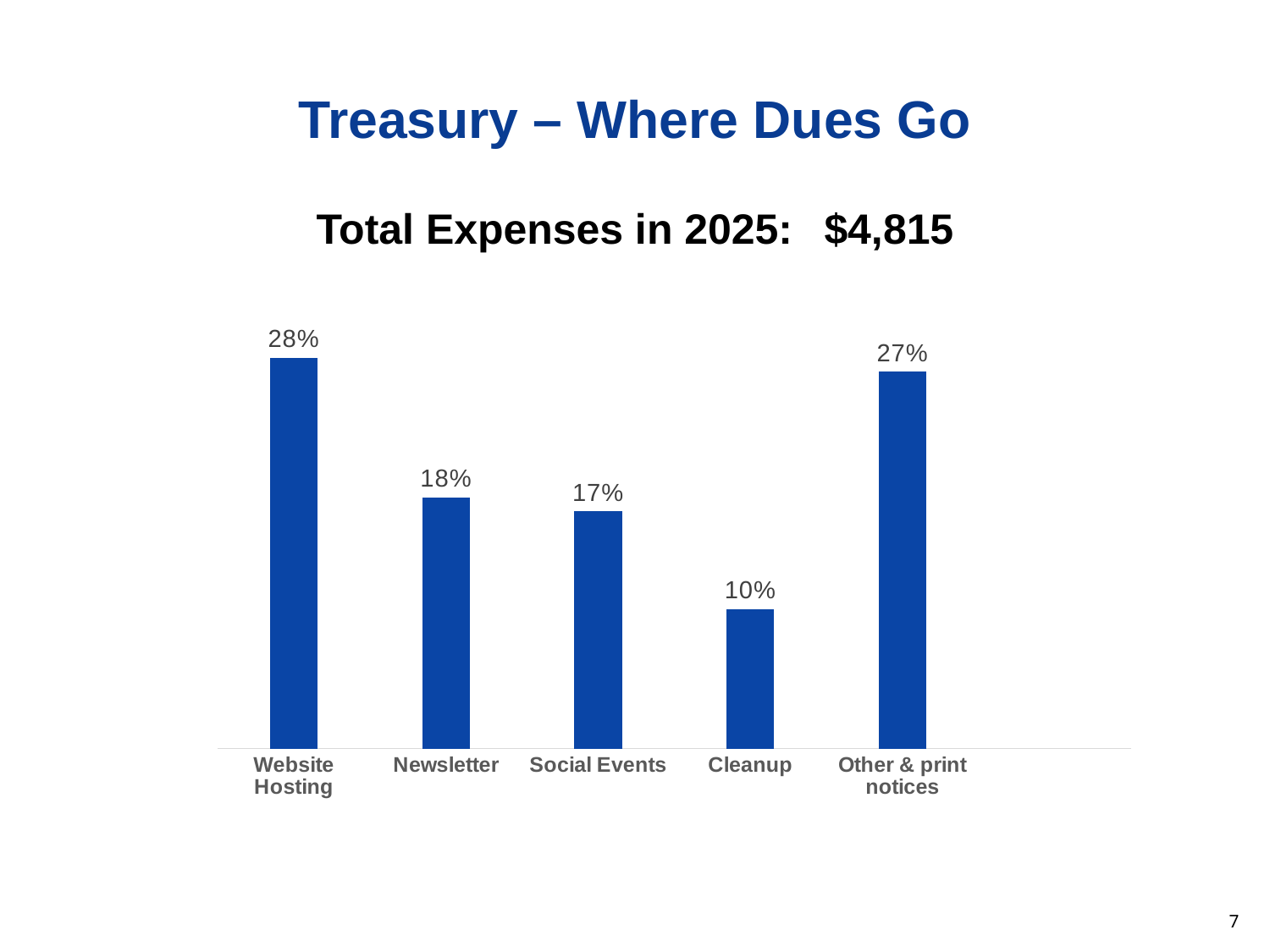
What percentage is shown for Social Events? 17% What is the value for Cleanup? 10% Which category has the lowest percentage? Cleanup What percentage is shown for Other & print notices? 27% What is the value shown for Newsletter? 18% What is the difference between the Newsletter and Social Events percentages? 1% Which category has the highest percentage? Website Hosting What kind of chart is shown on the slide? Bar chart Which is larger, the value for Other & print notices or the value for Newsletter? Other & print notices What is the difference between the Website Hosting and Cleanup percentages? 18% What percentage of expenses goes to Website Hosting? 28% How many categories are shown in the chart? 5